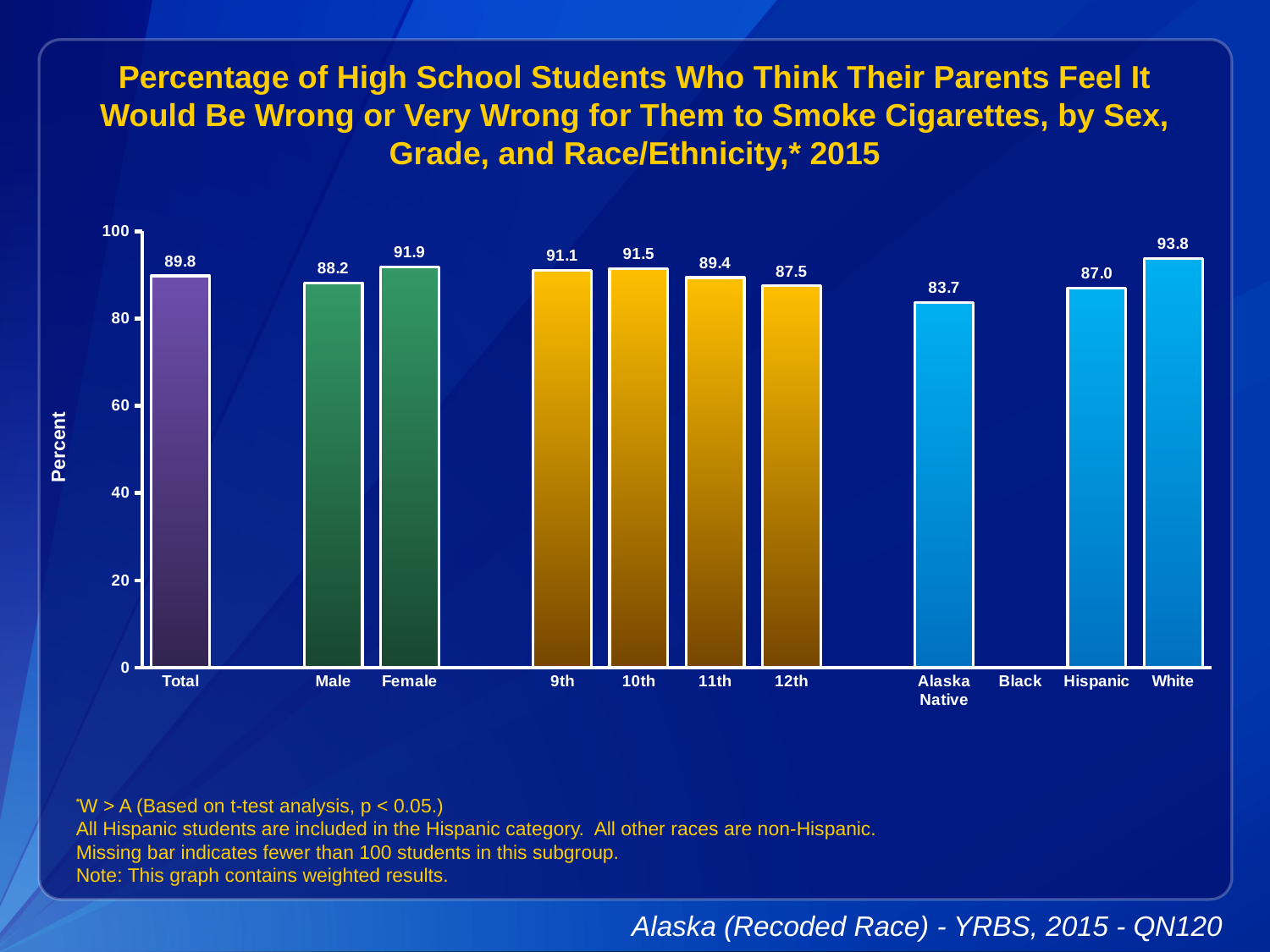
What is the difference between the Female and Male values? 3.7 What kind of chart is this? bar chart Which category has the lowest value among the bars shown? Alaska Native Which category on the x axis has no bar? Black Is the value for Hispanic greater or less than 80? greater How many categories have a bar plotted? 10 What is the value for Total? 89.8 What is the value for 12th grade? 87.5 What is the value for Alaska Native? 83.7 Which is larger, the value for 9th grade or 11th grade? 9th What is the value for Female? 91.9 Which category has the highest value? White